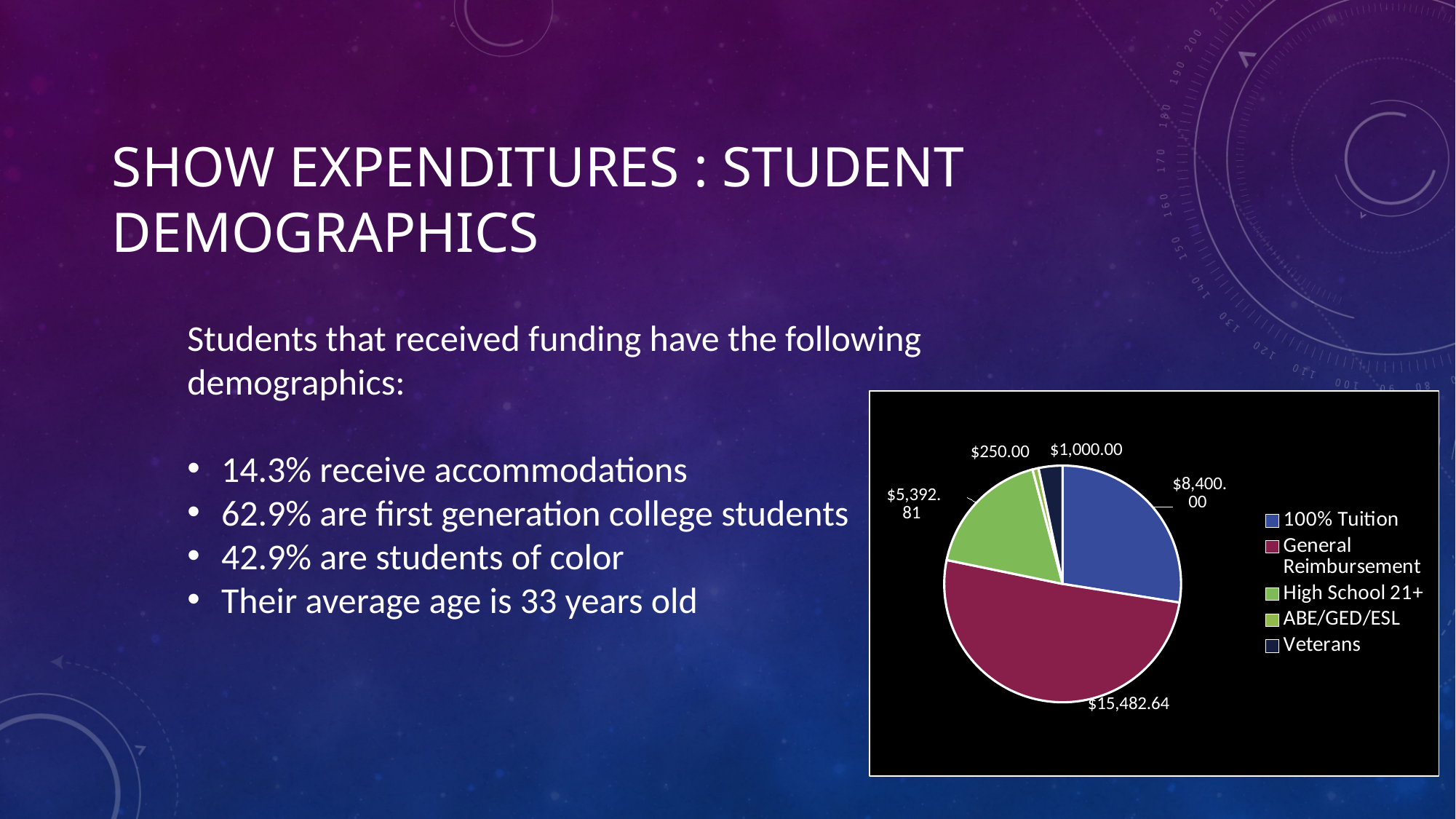
What is the difference between the General Reimbursement value and the 100% Tuition value? $7,082.64 Which is larger in the pie chart, the value for Veterans or the value for ABE/GED/ESL? Veterans What is the value shown for General Reimbursement in the pie chart? $15,482.64 What colour is the General Reimbursement slice in the pie chart? Red Which category has the smallest slice in the pie chart? ABE/GED/ESL How many entries does the legend of the pie chart list? 5 How many slices does the pie chart have? 5 Which category has the largest slice in the pie chart? General Reimbursement What type of chart is shown on the slide? Pie chart What is the value shown for 100% Tuition in the pie chart? $8,400.00 What is the value shown for Veterans in the pie chart? $1,000.00 What is the value shown for High School 21+ in the pie chart? $5,392.81